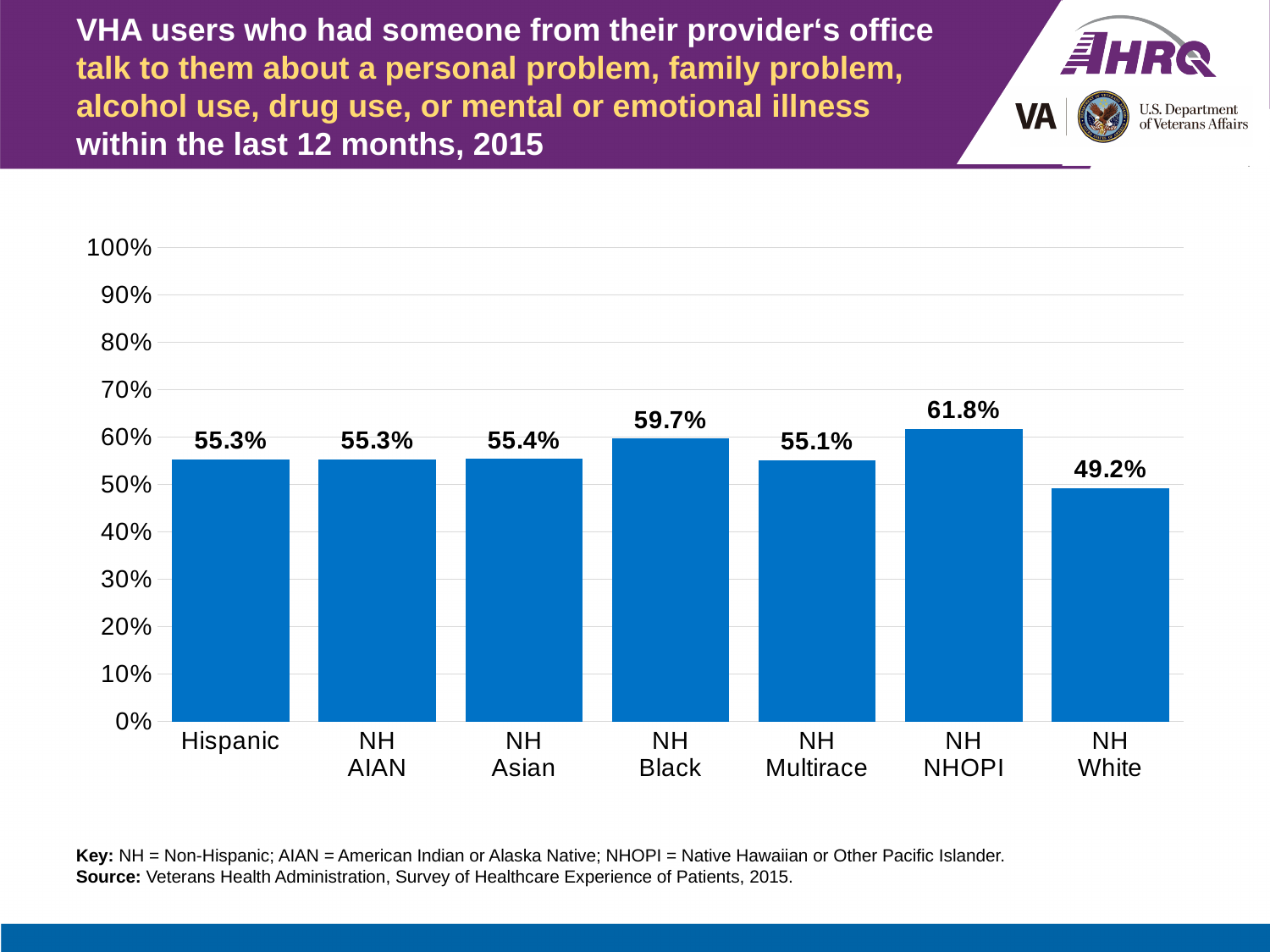
What is the difference between the values for NH Black and NH Asian? 4.3% Which category has the lowest value? NH White Is the value for NH White greater or less than 50%? less What kind of chart is shown on the slide? bar chart Which is larger, the value for NH Black or the value for NH Multirace? NH Black How many categories are shown on the x axis? 7 What is the difference between the values for NH NHOPI and NH White? 12.6% Which category has the highest value? NH NHOPI What is the value for NH White? 49.2% What is the value for NH Multirace? 55.1% What is the value for Hispanic? 55.3% What is the value for NH Black? 59.7%